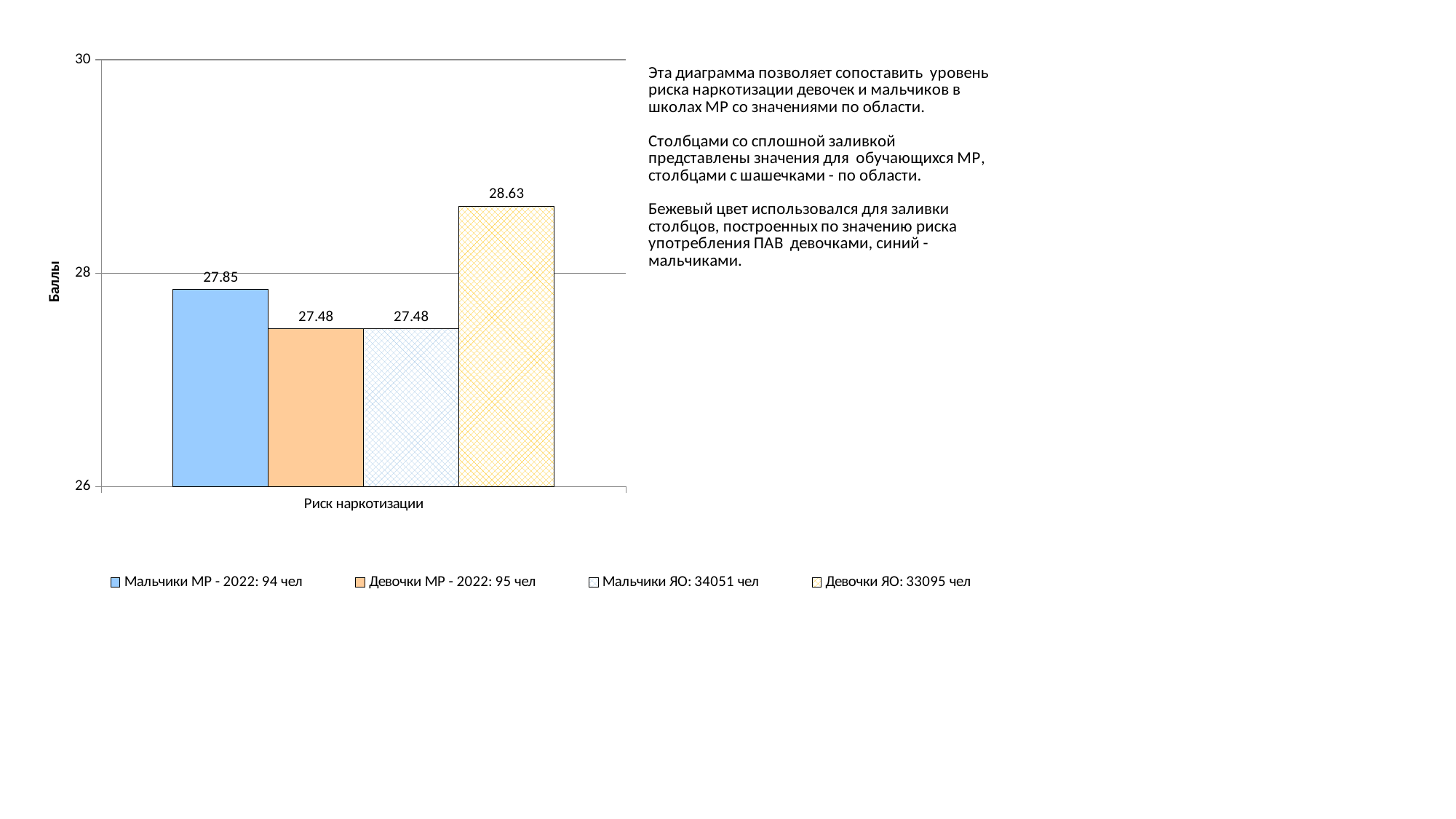
Which is larger, the value for "Мальчики МР - 2022: 94 чел" or the value for "Девочки ЯО: 33095 чел"? Девочки ЯО: 33095 чел What is the value for the series "Мальчики МР - 2022: 94 чел"? 27.85 What is the label of the vertical axis? Баллы What is the value for the series "Мальчики ЯО: 34051 чел"? 27.48 What kind of chart is shown on the slide? bar chart Is the value for "Девочки ЯО: 33095 чел" greater or less than 28? greater What is the difference between the values for "Девочки ЯО: 33095 чел" and "Девочки МР - 2022: 95 чел"? 1.15 What is the difference between the values for "Мальчики МР - 2022: 94 чел" and "Мальчики ЯО: 34051 чел"? 0.37 What is the value for the series "Девочки МР - 2022: 95 чел"? 27.48 Which series has the highest value? Девочки ЯО: 33095 чел What is the value for the series "Девочки ЯО: 33095 чел"? 28.63 How many series does the legend list? 4